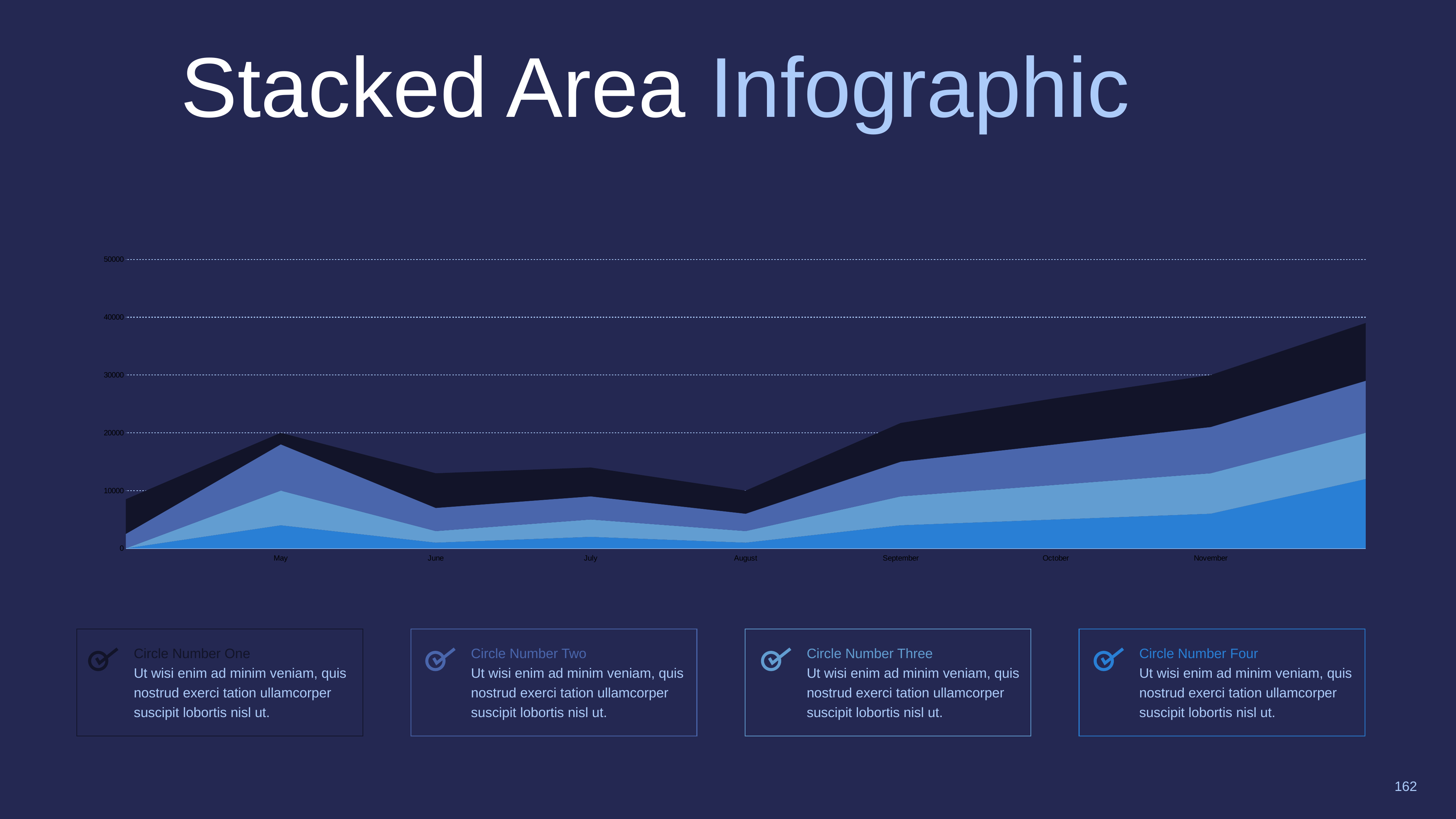
What is the title of the slide containing the chart? Stacked Area Infographic Do the stacked totals rise or fall from August to November? rise Is the stacked total for October greater or less than 20000? greater Which has the larger stacked total, September or June? September Is the stacked total for July greater or less than 20000? less What kind of chart is shown on the slide? Stacked area chart Is the stacked total for June greater or less than 20000? less How many month labels are shown on the x axis of the chart? 7 Among the labeled months, which has the highest stacked total? November Which month is the first labeled on the x axis of the chart? May